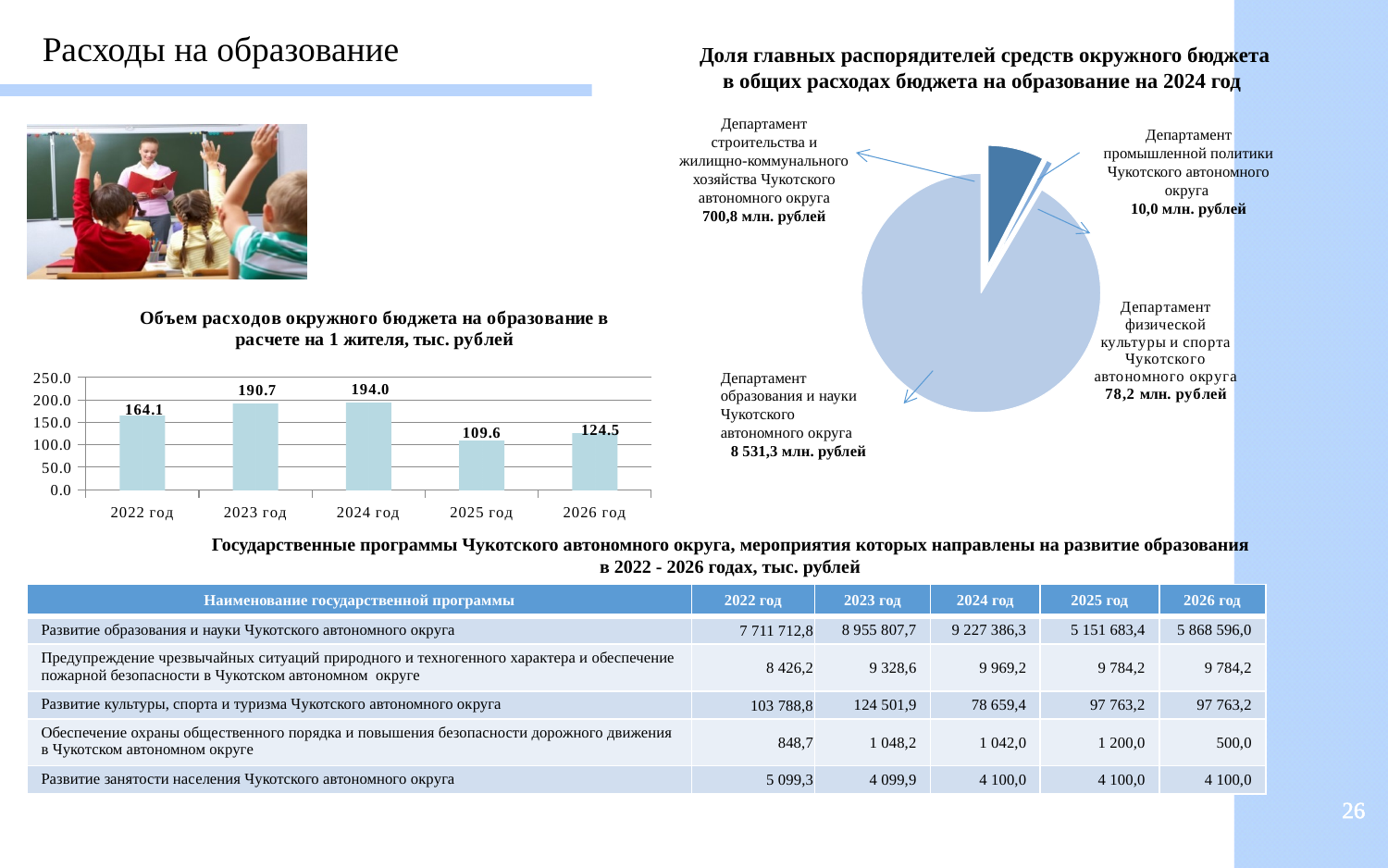
On the bar chart 'Объем расходов окружного бюджета на образование в расчете на 1 жителя', what is the difference between the values for 2023 год and 2022 год? 26.6 On the pie chart 'Доля главных распорядителей средств окружного бюджета в общих расходах бюджета на образование на 2024 год', which department has the smallest value? Департамент промышленной политики Чукотского автономного округа On the bar chart 'Объем расходов окружного бюджета на образование в расчете на 1 жителя', what is the value for 2022 год? 164.1 On the bar chart 'Объем расходов окружного бюджета на образование в расчете на 1 жителя', do the values rise or fall from 2024 год to 2025 год? fall On the bar chart 'Объем расходов окружного бюджета на образование в расчете на 1 жителя', what is the value for 2025 год? 109.6 On the pie chart 'Доля главных распорядителей средств окружного бюджета в общих расходах бюджета на образование на 2024 год', what is the value for Департамент образования и науки Чукотского автономного округа? 8 531,3 млн. рублей What kind of chart is 'Объем расходов окружного бюджета на образование в расчете на 1 жителя'? bar chart On the bar chart 'Объем расходов окружного бюджета на образование в расчете на 1 жителя', which is larger: the value for 2026 год or 2025 год? 2026 год On the bar chart 'Объем расходов окружного бюджета на образование в расчете на 1 жителя', how many years are shown? 5 On the bar chart 'Объем расходов окружного бюджета на образование в расчете на 1 жителя', which year has the lowest value? 2025 год What kind of chart is 'Доля главных распорядителей средств окружного бюджета в общих расходах бюджета на образование на 2024 год'? pie chart On the bar chart 'Объем расходов окружного бюджета на образование в расчете на 1 жителя', which year has the highest value? 2024 год